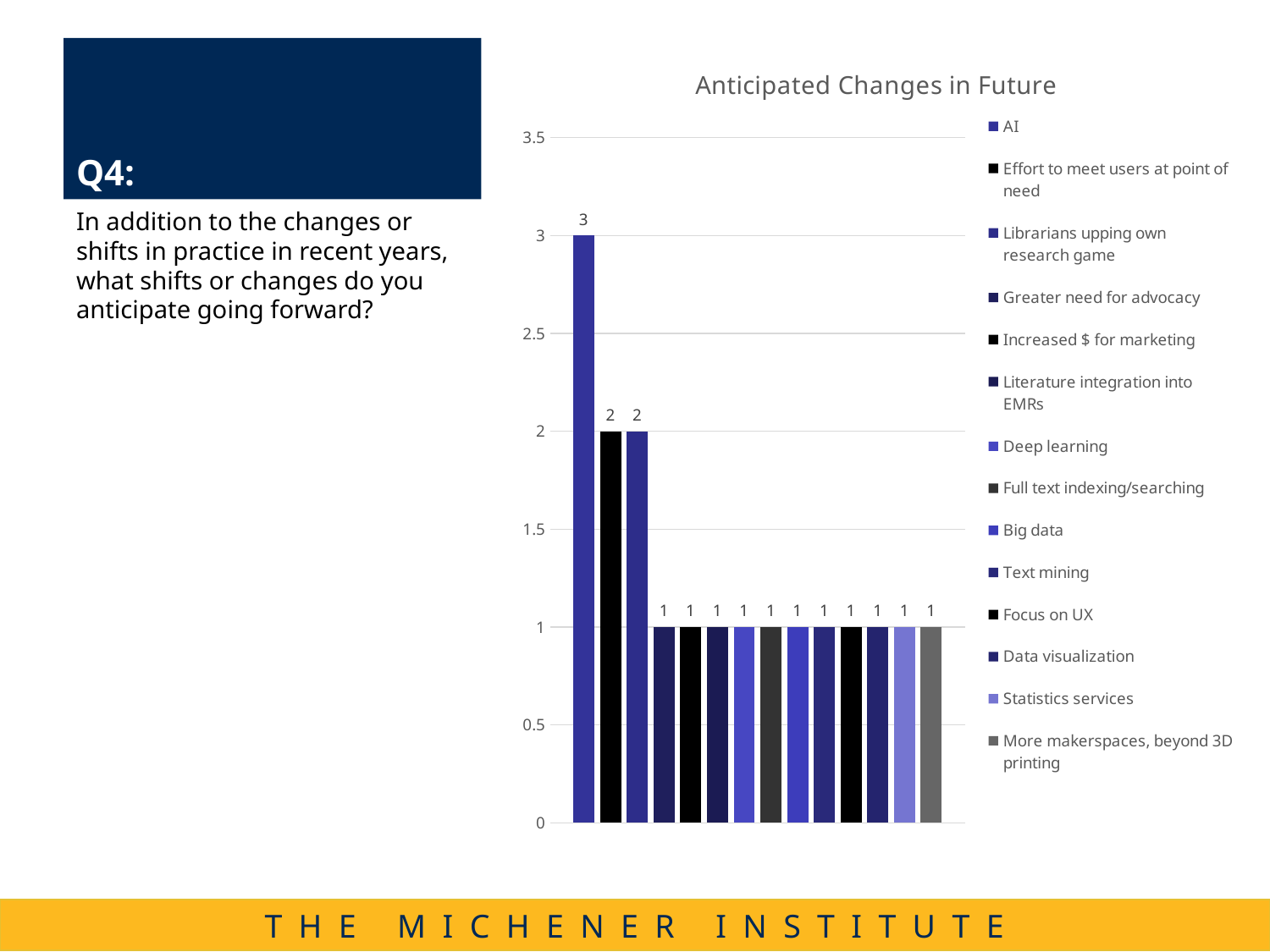
Is the value for AI greater or less than 2.5? greater What is the value for AI in the Anticipated Changes in Future chart? 3 How many bars are plotted in the chart? 14 Which is larger, the value for AI or the value for Deep learning? AI What is the value for Effort to meet users at point of need? 2 How many series does the legend list? 14 Which category has the highest value in the chart? AI What is the value for Librarians upping own research game? 2 What is the value for Greater need for advocacy? 1 What is the difference between the value for AI and the value for Effort to meet users at point of need? 1 What is the title of the chart? Anticipated Changes in Future What kind of chart is shown on the slide? bar chart